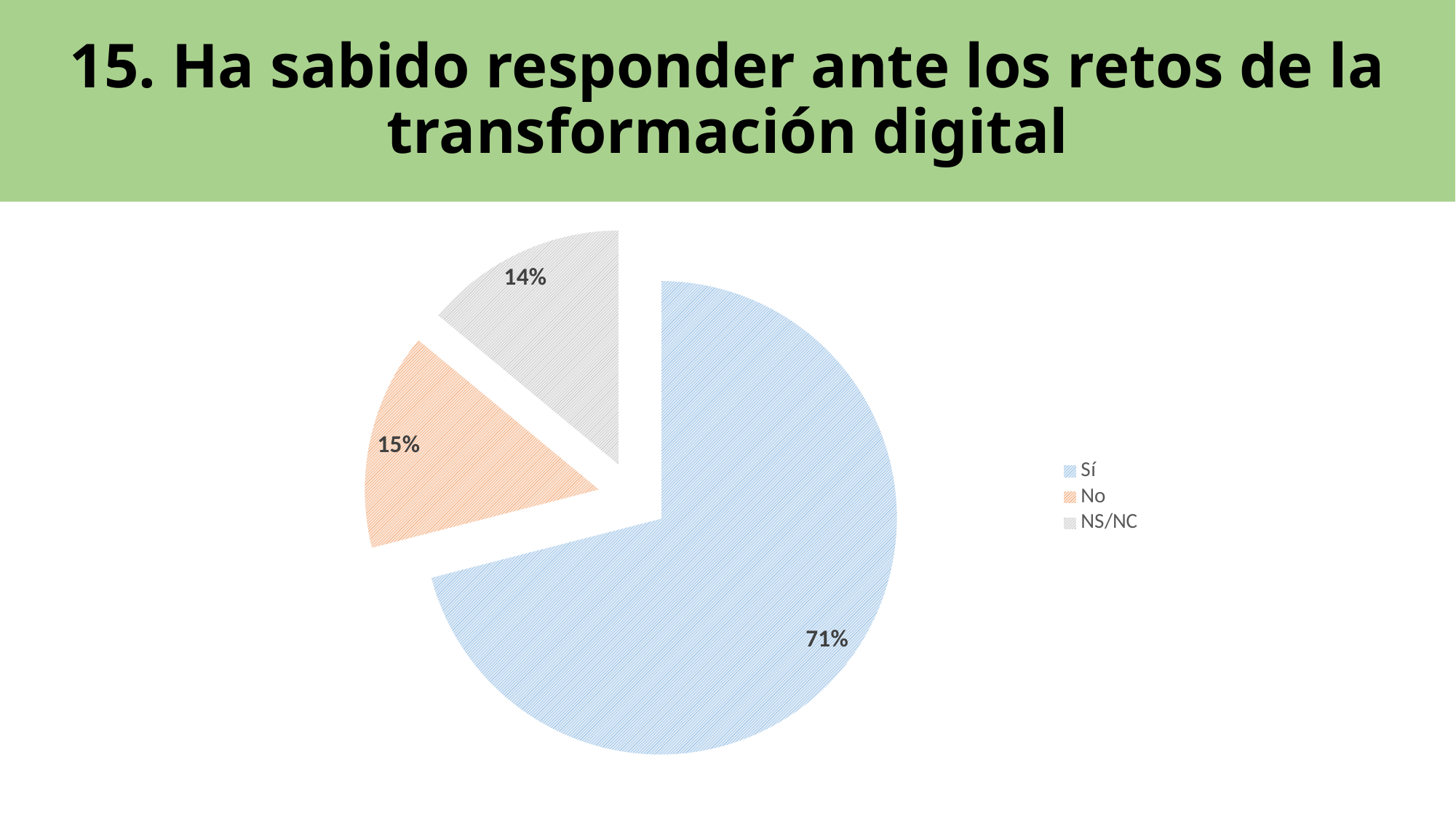
How many categories does the pie chart have? 3 What is the difference in percentage points between the "Sí" and "No" slices? 56 Which is larger, the "Sí" slice or the "NS/NC" slice? Sí How many entries does the legend list? 3 What type of chart is shown on the slide? Pie chart What percentage of respondents answered "Sí"? 71% Which category has the smallest share of the pie? NS/NC What colour is the "No" slice in the pie chart? Orange Which category has the largest share of the pie? Sí What percentage of respondents answered "No"? 15% What percentage is shown for the "NS/NC" slice? 14% What is the difference in percentage points between the "No" and "NS/NC" slices? 1